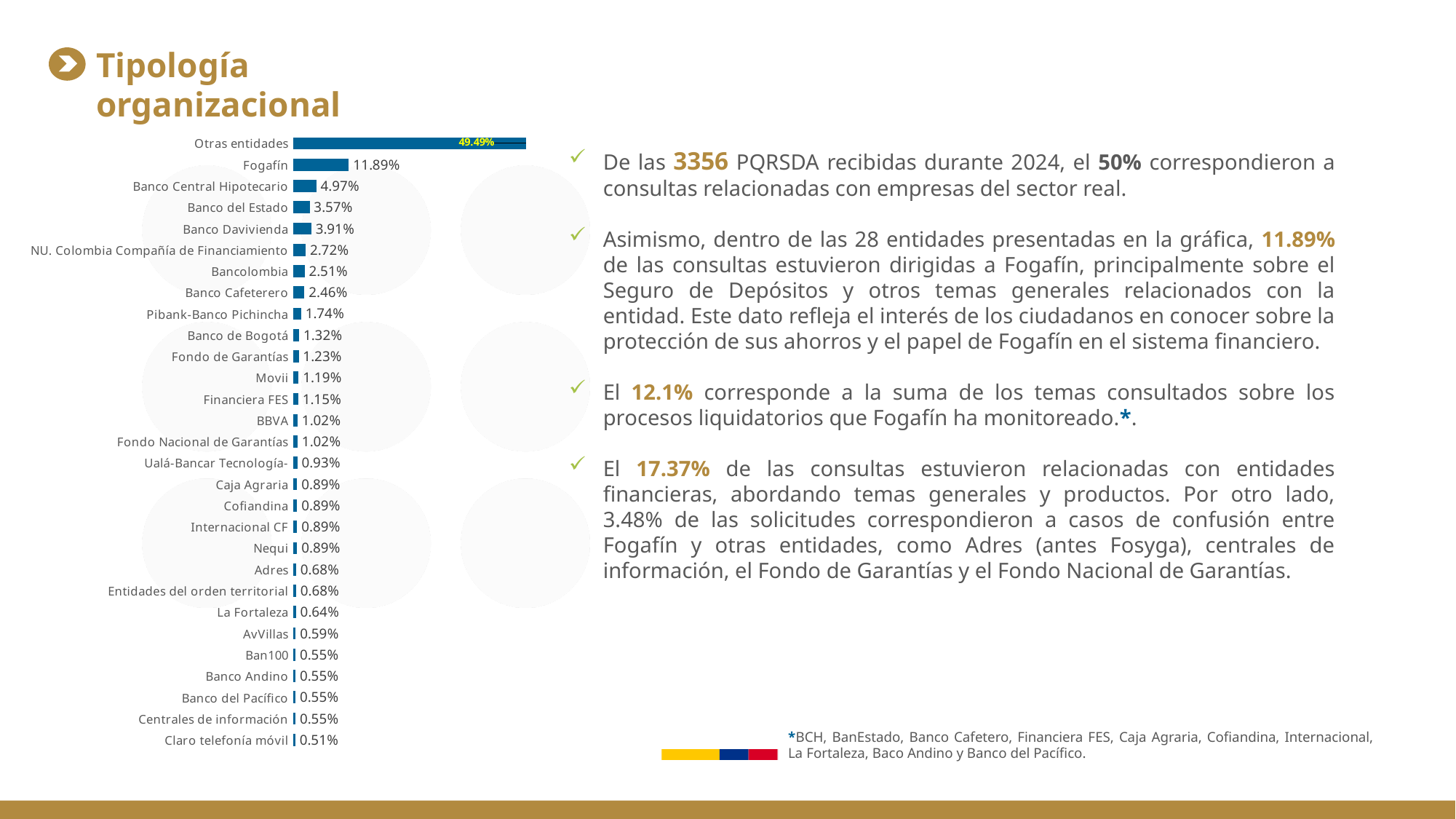
What is the value for Bancolombia? 2.51% Which category has the lowest value? Claro telefonía móvil What is the value for Fogafín? 11.89% Which category has the highest value? Otras entidades What is the value for Banco Central Hipotecario? 4.97% What kind of chart is shown on the slide? bar chart What is the difference between the values for Fogafín and Banco Central Hipotecario? 6.92% How many categories are shown in the chart? 29 What is the value for Pibank-Banco Pichincha? 1.74% What is the difference between the values for Otras entidades and Fogafín? 37.60% What is the value for Claro telefonía móvil? 0.51% Which is larger, the value for Banco Davivienda or the value for Banco del Estado? Banco Davivienda